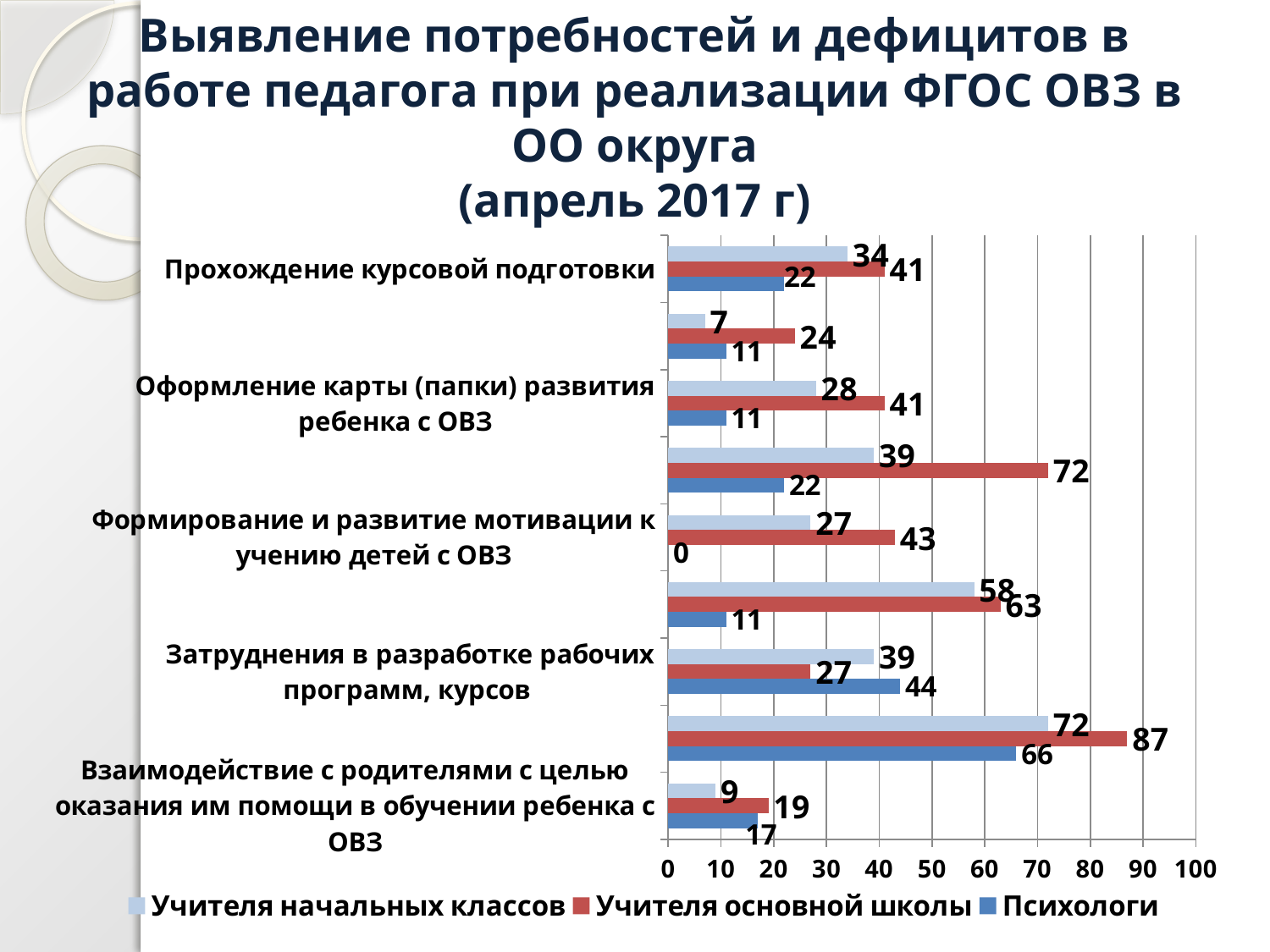
What kind of chart is shown on the slide? bar chart What is the value for Психологи in the category Прохождение курсовой подготовки? 22 What colour represents the series Учителя основной школы in the legend? red In the category Затруднения в разработке рабочих программ, курсов, which is larger: the value for Психологи or for Учителя основной школы? Психологи Which series has the highest value in the category Формирование и развитие мотивации к учению детей с ОВЗ? Учителя основной школы What is the largest value labelled anywhere on the chart? 87 How many series does the legend list? 3 What is the value for Учителя начальных классов in the category Оформление карты (папки) развития ребенка с ОВЗ? 28 What is the value for Учителя основной школы in the category Прохождение курсовой подготовки? 41 What is the value for Психологи in the category Затруднения в разработке рабочих программ, курсов? 44 What is the value for Психологи in the category Формирование и развитие мотивации к учению детей с ОВЗ? 0 In the category Прохождение курсовой подготовки, how much larger is the value for Учителя основной школы than for Учителя начальных классов? 7